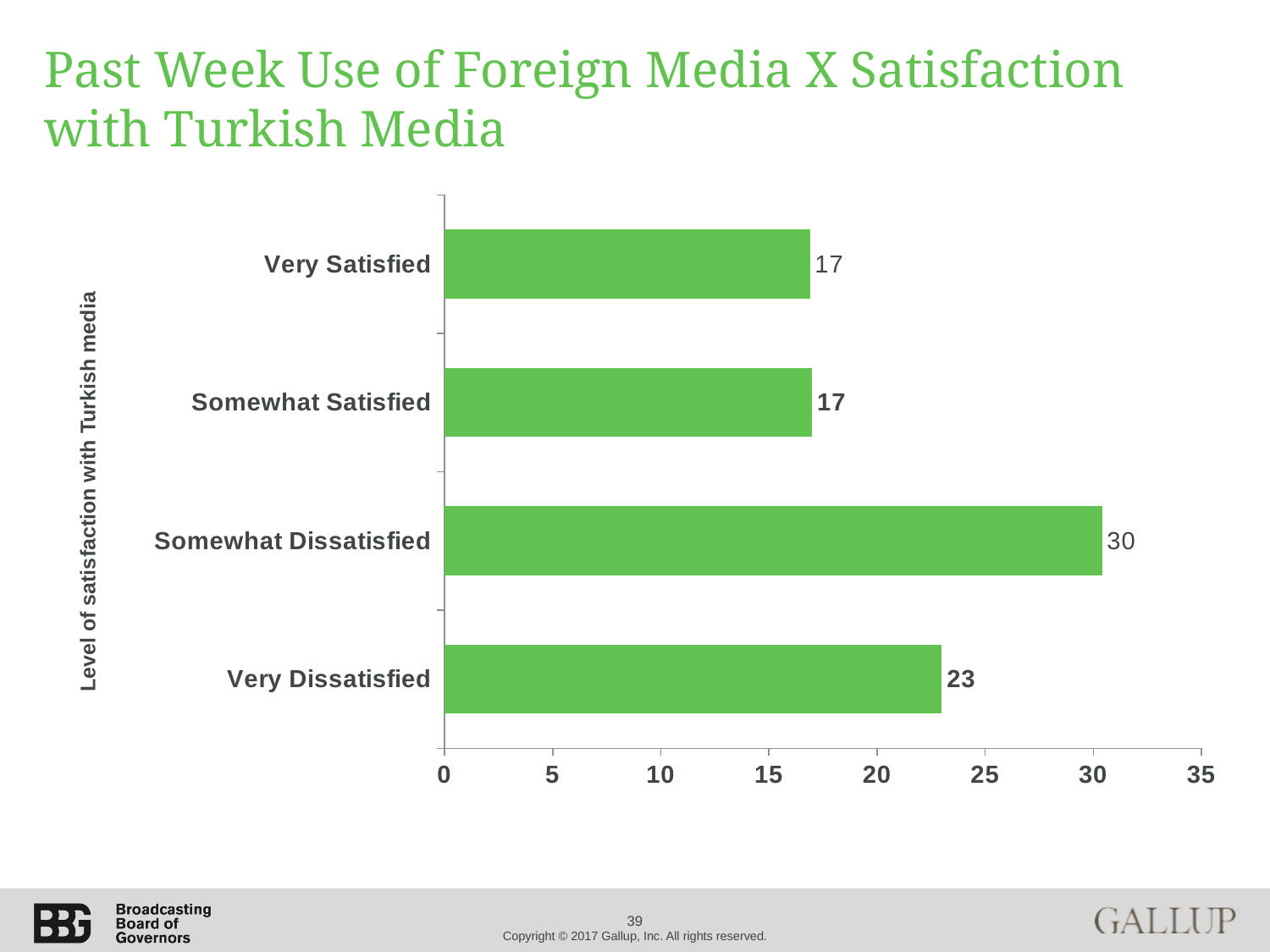
Which is larger, the value for Very Dissatisfied or the value for Very Satisfied? Very Dissatisfied What is the label of the vertical axis? Level of satisfaction with Turkish media What is the value for Somewhat Dissatisfied? 30 What kind of chart is shown on the slide? Bar chart How many categories are shown in the chart? 4 Is the value for Somewhat Dissatisfied greater or less than 25? greater Which category has the highest value? Somewhat Dissatisfied What is the value for Very Dissatisfied? 23 Is the value for Somewhat Satisfied greater or less than 20? less What is the value for Very Satisfied? 17 What is the difference between the values for Very Dissatisfied and Somewhat Satisfied? 6 What is the difference between the values for Somewhat Dissatisfied and Very Dissatisfied? 7